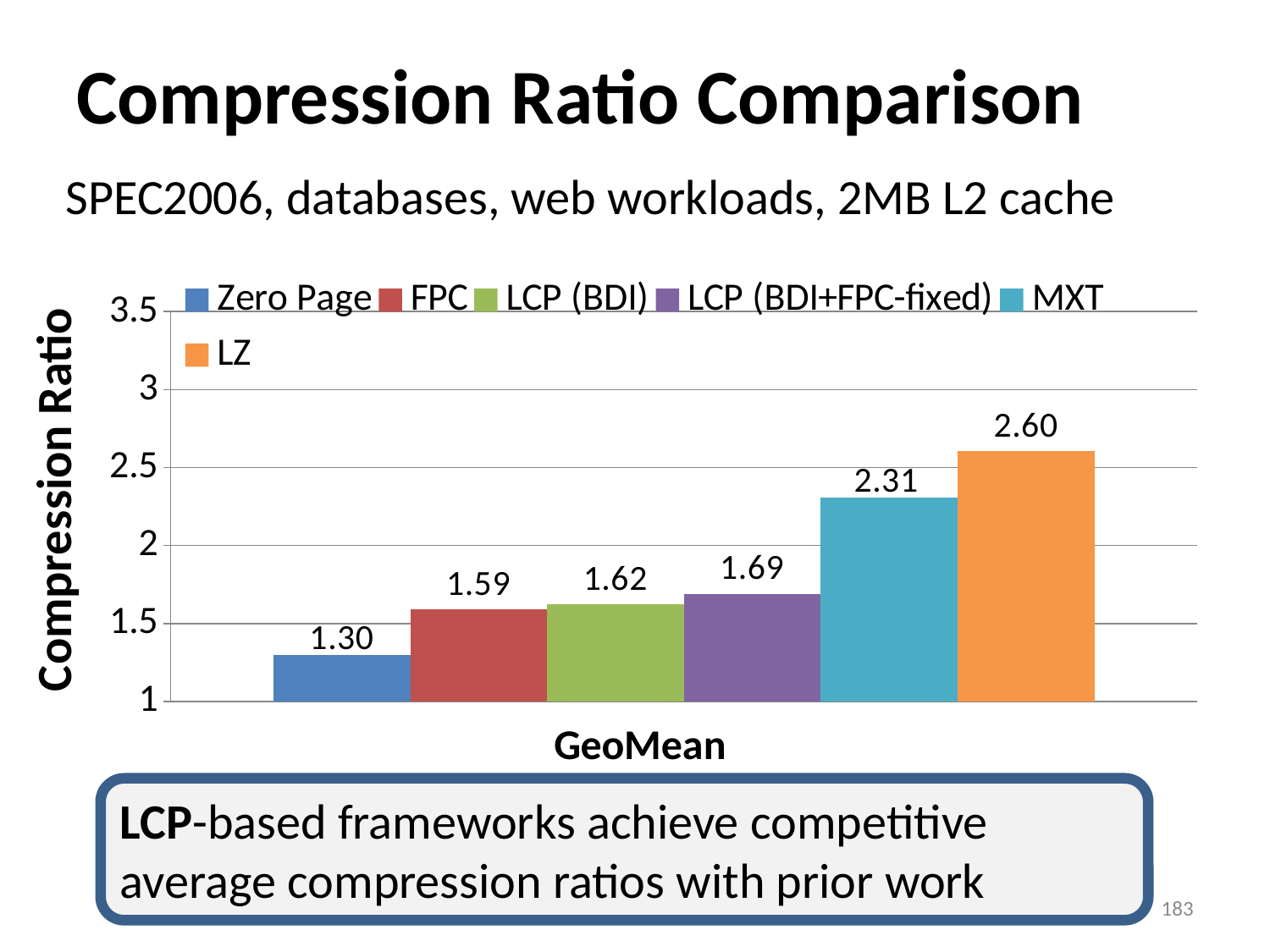
What kind of chart is shown on the slide? Bar chart How many series does the legend list? 6 What is the compression ratio for LZ? 2.60 What is the difference between the compression ratios of LCP (BDI) and FPC? 0.03 Which series has the lowest compression ratio? Zero Page What is the label on the y axis of the chart? Compression Ratio Which has a higher compression ratio, MXT or LCP (BDI+FPC-fixed)? MXT Which series has the highest compression ratio? LZ What is the compression ratio for LCP (BDI+FPC-fixed)? 1.69 What is the compression ratio for MXT? 2.31 What is the difference between the compression ratios of LZ and MXT? 0.29 What is the compression ratio for Zero Page? 1.30